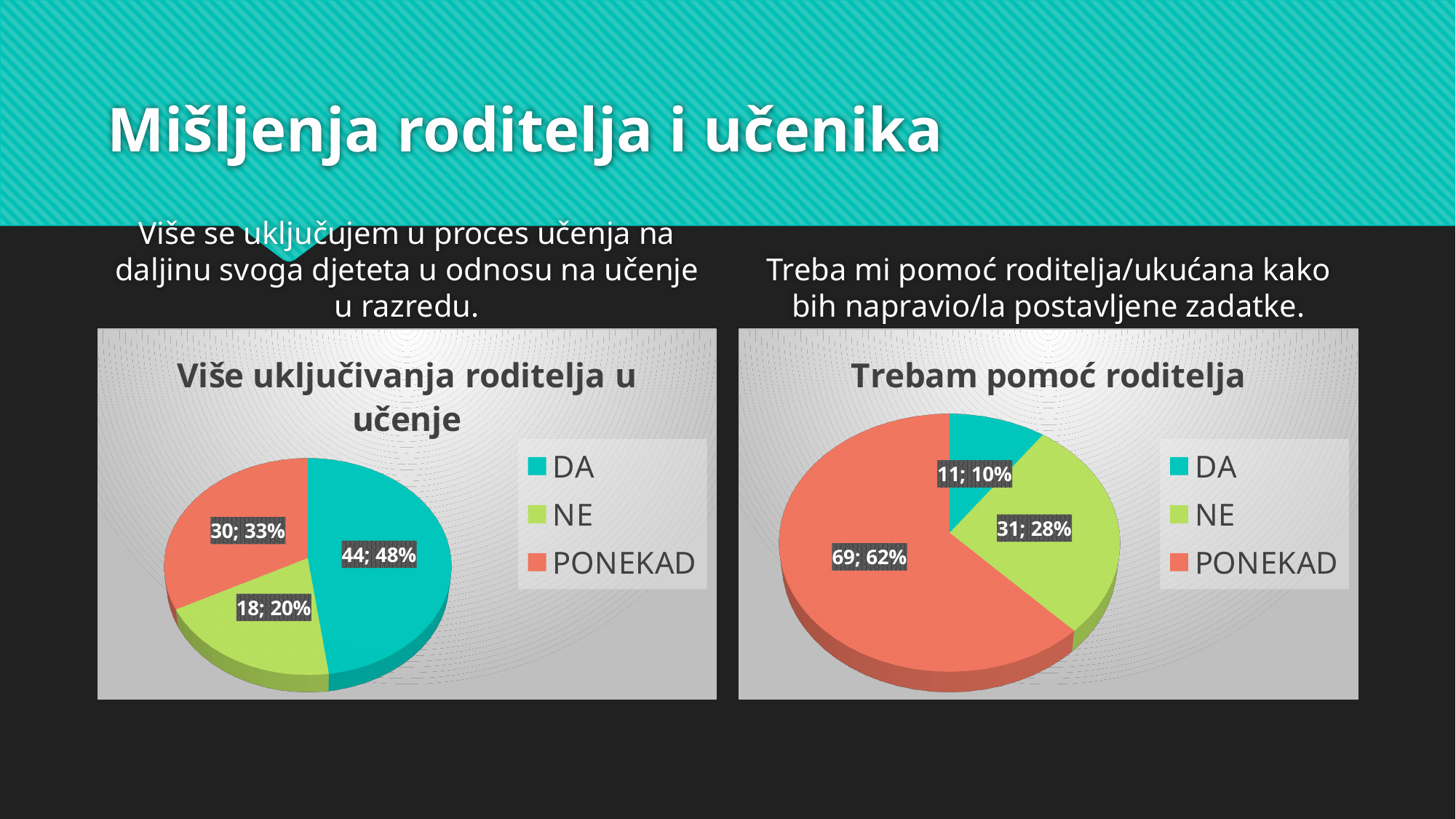
In the left chart 'Više uključivanja roditelja u učenje', which is larger: PONEKAD or NE? PONEKAD In the left chart 'Više uključivanja roditelja u učenje', what is the value for NE? 18; 20% In the right chart 'Trebam pomoć roditelja', what share of the pie does NE represent? 28% In the right chart 'Trebam pomoć roditelja', what is the difference in count between PONEKAD and NE? 38 In the left chart 'Više uključivanja roditelja u učenje', which category has the largest slice? DA What type of chart is 'Trebam pomoć roditelja'? Pie chart In the right chart 'Trebam pomoć roditelja', what is the value for PONEKAD? 69; 62% How many categories does the legend of the left chart 'Više uključivanja roditelja u učenje' list? 3 In the left chart 'Više uključivanja roditelja u učenje', what is the value for DA? 44; 48% In the right chart 'Trebam pomoć roditelja', what colour is the PONEKAD slice? Orange-red In the right chart 'Trebam pomoć roditelja', what is the value for DA? 11; 10% In the right chart 'Trebam pomoć roditelja', which category has the smallest slice? DA